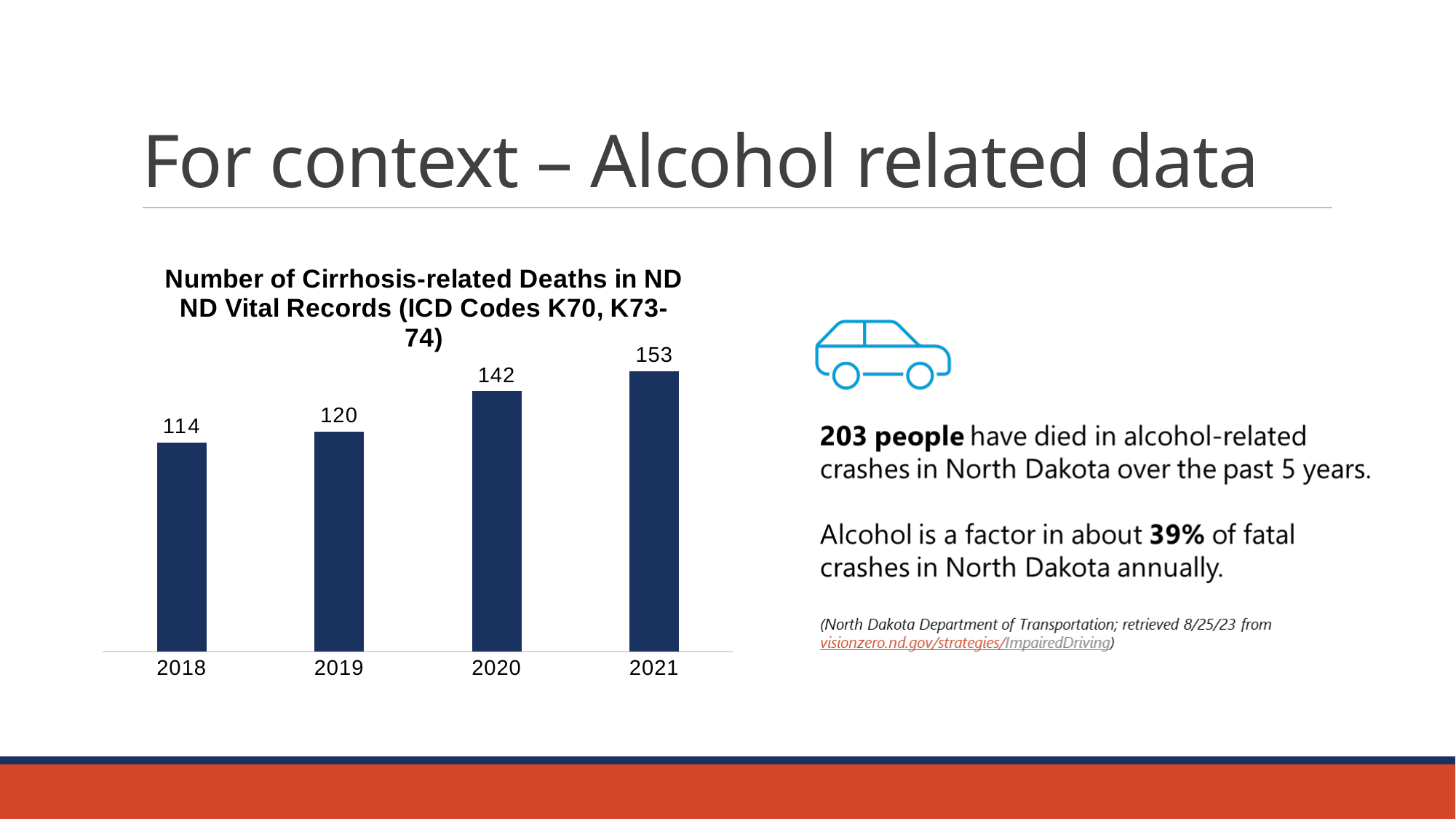
How many years are shown on the chart? 4 What is the number of cirrhosis-related deaths in ND for 2020? 142 Do the cirrhosis-related deaths rise or fall from 2018 to 2021? Rise What kind of chart is used to show the cirrhosis-related deaths? Bar chart What is the number of cirrhosis-related deaths in ND for 2021? 153 What is the number of cirrhosis-related deaths in ND for 2018? 114 Which year has the lowest number of cirrhosis-related deaths? 2018 Which year had more cirrhosis-related deaths, 2019 or 2020? 2020 What is the difference in cirrhosis-related deaths between 2020 and 2019? 22 Which year has the highest number of cirrhosis-related deaths? 2021 What is the number of cirrhosis-related deaths in ND for 2019? 120 What is the difference in cirrhosis-related deaths between 2021 and 2018? 39